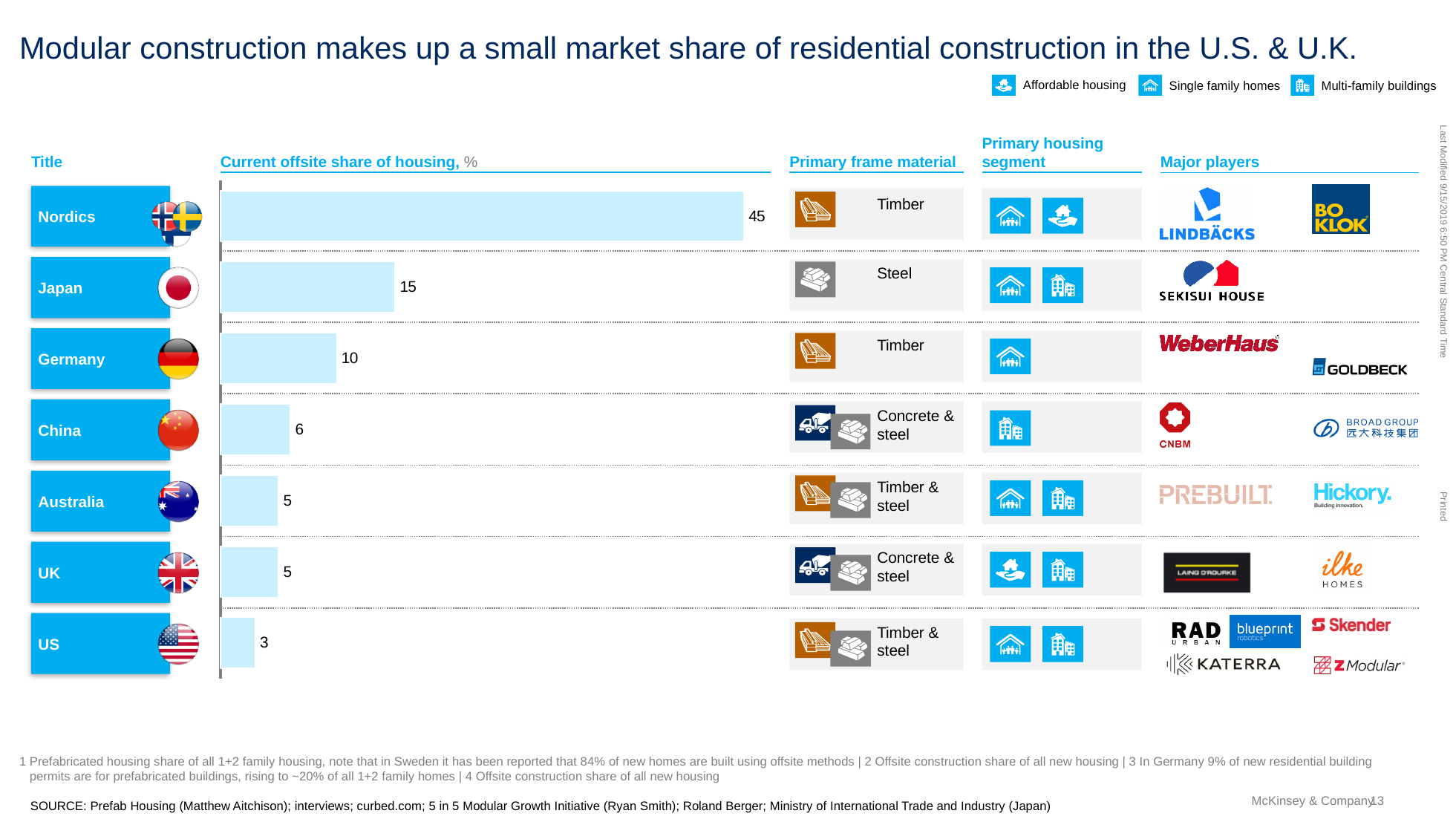
Which country has the lowest current offsite share of housing? US What kind of chart shows the current offsite share of housing? Bar chart Which region has the highest current offsite share of housing? Nordics What is the current offsite share of housing for the US? 3 How many countries or regions are shown in the bar chart? 7 Do the bar values rise or fall going down the chart from Nordics to US? Fall What is the current offsite share of housing for the Nordics? 45 Which has a larger current offsite share of housing, Japan or Germany? Japan What is the current offsite share of housing for Japan? 15 What is the difference between the offsite share of housing for Germany and China? 4 What is the primary frame material listed for Japan? Steel What is the difference between the offsite share of housing for the Nordics and Japan? 30